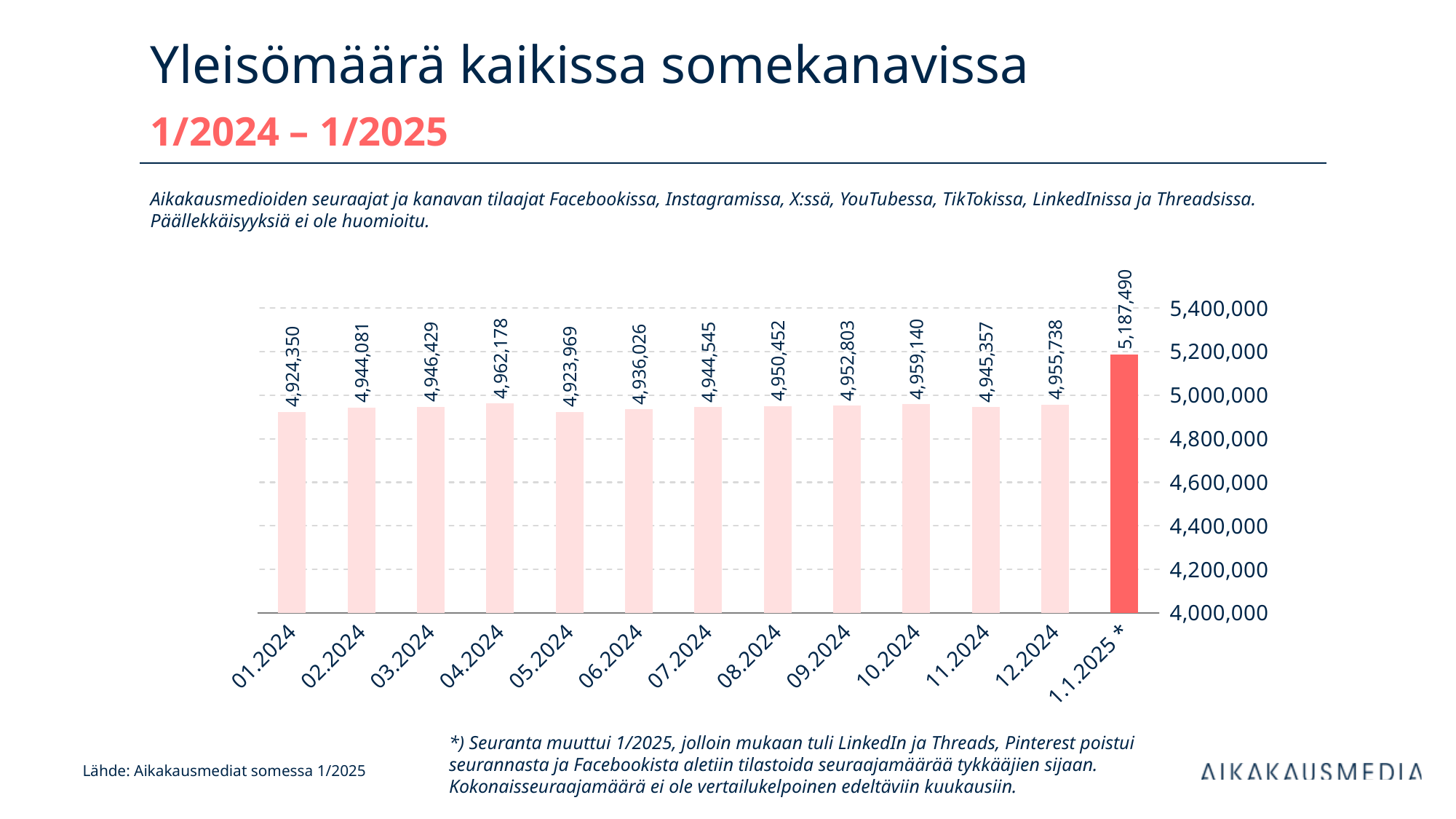
Which is larger, the value for 04.2024 or the value for 05.2024? 04.2024 What is the difference between the values for 04.2024 and 01.2024? 37,828 What is the title of the chart? Yleisömäärä kaikissa somekanavissa What is the value for 01.2024? 4,924,350 What is the value for 1.1.2025 *? 5,187,490 What kind of chart is shown on the slide? bar chart How many bars are shown in the chart? 13 Which month has the lowest value? 05.2024 What is the value for 07.2024? 4,944,545 What is the difference between the values for 1.1.2025 * and 12.2024? 231,752 Which month has the highest value? 1.1.2025 * Is the value for 1.1.2025 * greater or less than 5,000,000? greater